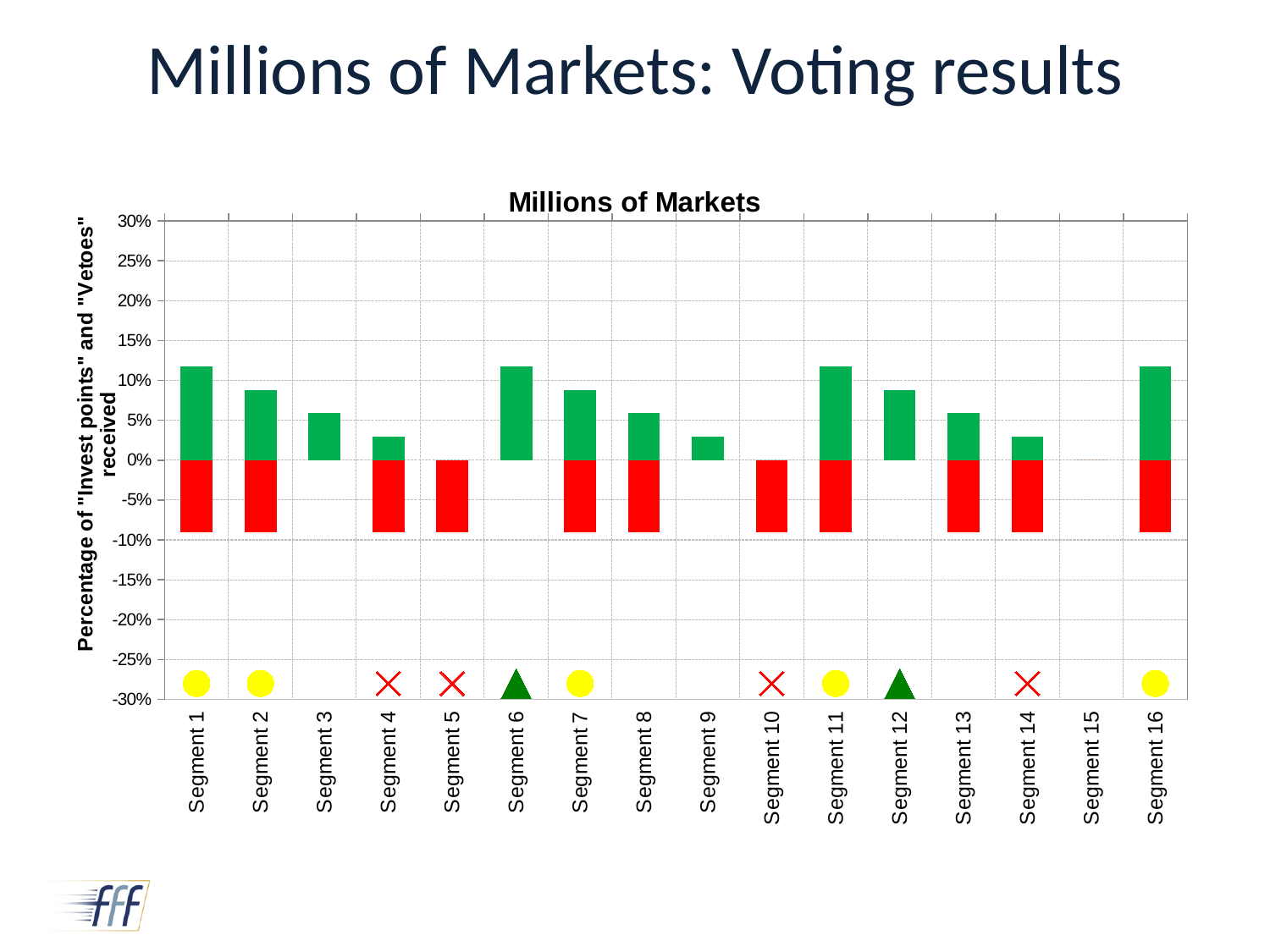
Which has the taller green bar, Segment 1 or Segment 3? Segment 1 Is the green bar for Segment 4 greater or less than 5%? less Which segment has neither a green nor a red bar? Segment 15 Is the red bar for Segment 10 greater or less than -10%? greater How many segments are shown along the x axis of the chart? 16 Is the green bar for Segment 3 greater or less than 10%? less Which has the taller green bar, Segment 2 or Segment 4? Segment 2 What is the label on the vertical axis of the chart? Percentage of "Invest points" and "Vetoes" received What kind of chart is shown on the slide? Bar chart What is the title of the chart? Millions of Markets